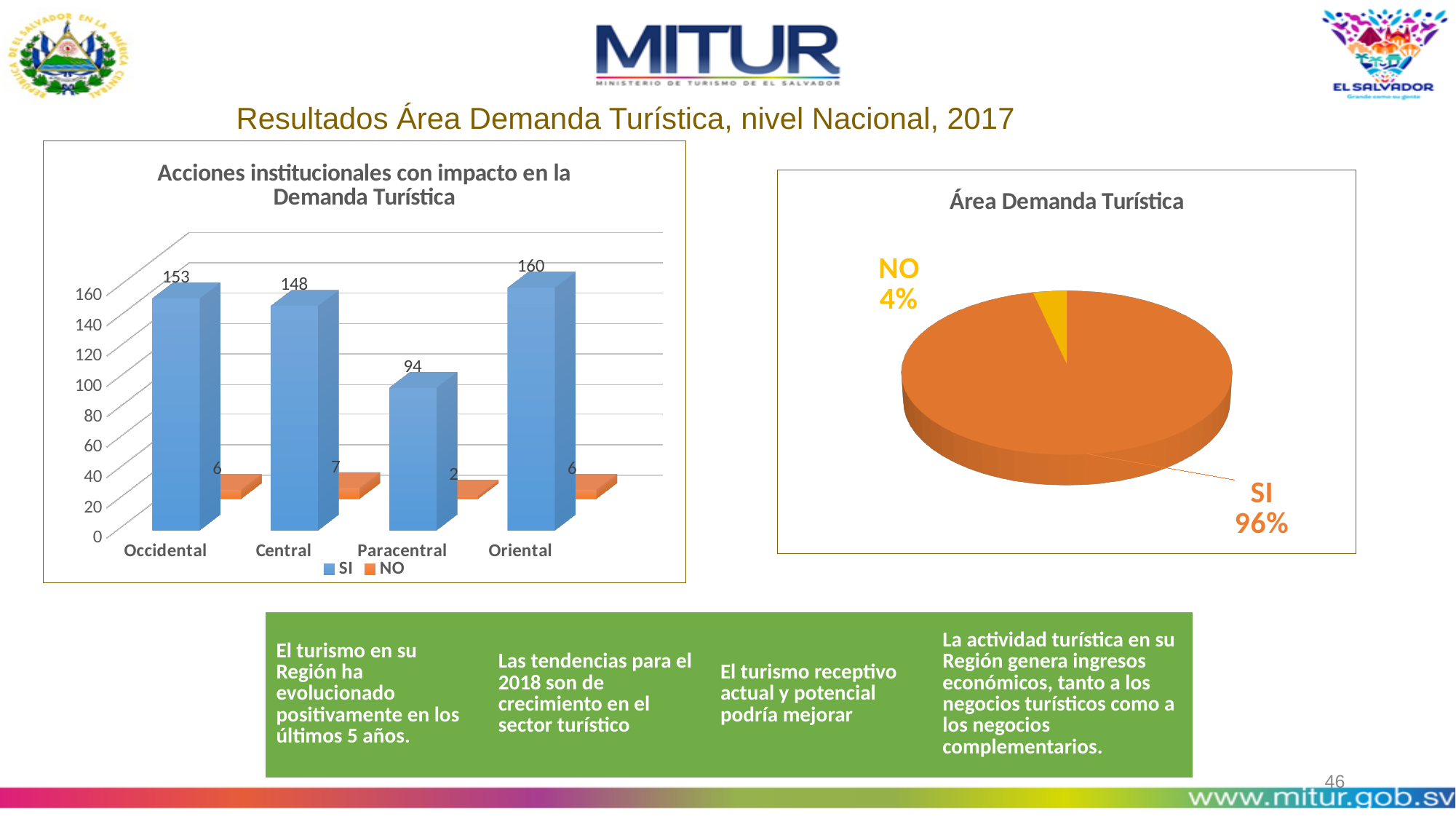
In the chart 'Acciones institucionales con impacto en la Demanda Turística', what is the SI value for Occidental? 153 In the chart 'Acciones institucionales con impacto en la Demanda Turística', how many regions are shown on the x axis? 4 In the chart 'Acciones institucionales con impacto en la Demanda Turística', how many series does the legend list? 2 In the pie chart 'Área Demanda Turística', what share does NO have? 4% In the chart 'Acciones institucionales con impacto en la Demanda Turística', which region has the lowest SI value? Paracentral In the chart 'Acciones institucionales con impacto en la Demanda Turística', which region has the highest SI value? Oriental In the chart 'Acciones institucionales con impacto en la Demanda Turística', what is the NO value for Central? 7 What kind of chart is 'Acciones institucionales con impacto en la Demanda Turística'? Bar chart What kind of chart is 'Área Demanda Turística'? Pie chart In the chart 'Acciones institucionales con impacto en la Demanda Turística', what is the difference between the SI values for Oriental and Paracentral? 66 In the chart 'Acciones institucionales con impacto en la Demanda Turística', which is larger: the SI value for Occidental or for Central? Occidental In the pie chart 'Área Demanda Turística', what share does SI have? 96%